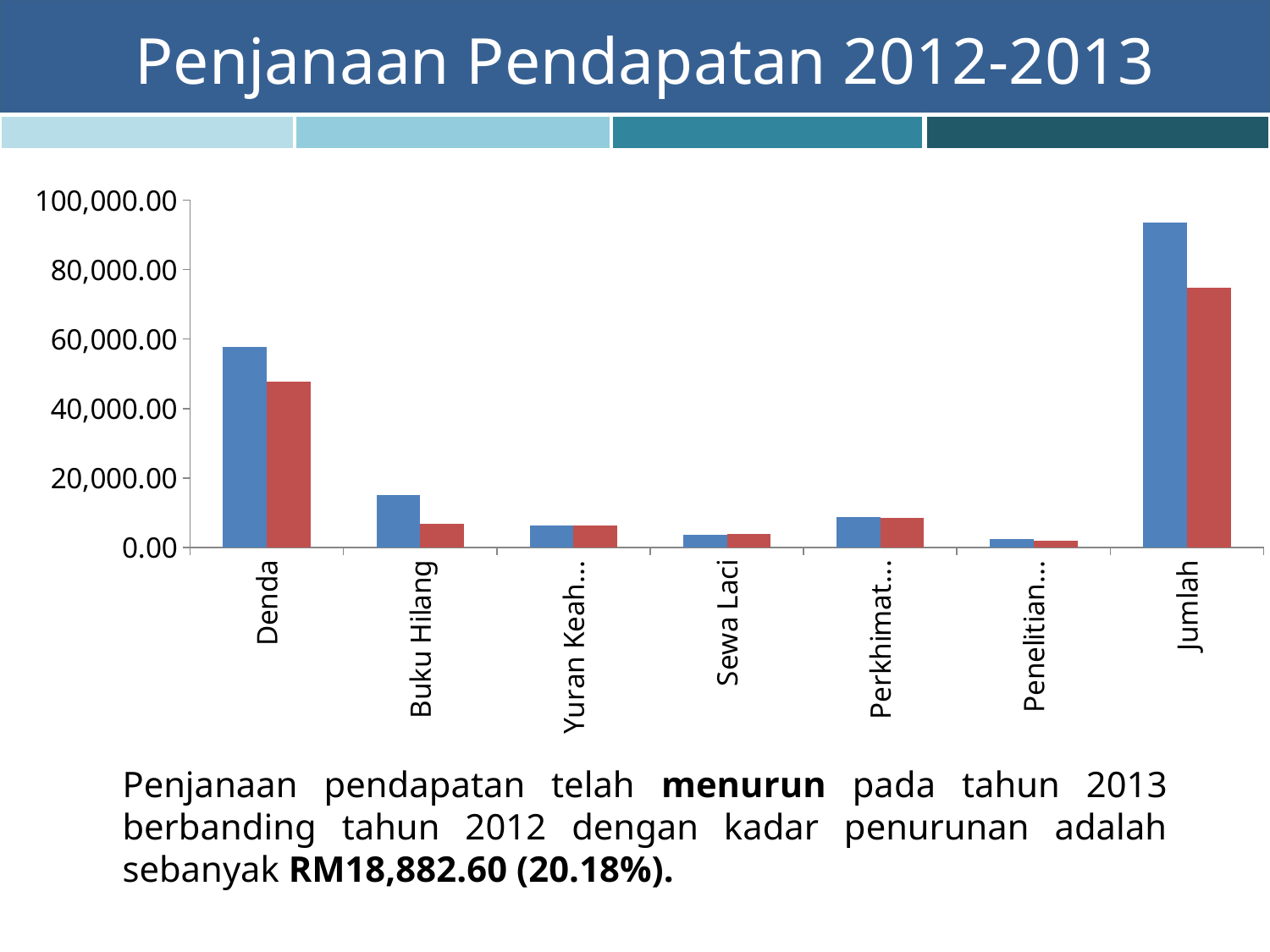
Is the blue bar for Jumlah greater or less than 80,000.00? greater What kind of chart is shown on the slide? bar chart For Buku Hilang, which bar is taller, the blue one or the red one? blue Which category has the tallest bars in the chart? Jumlah How many categories are shown on the x axis of the chart? 7 Excluding Jumlah, which category has the highest blue bar? Denda Is the blue bar for Buku Hilang greater or less than 20,000.00? less For Denda, which bar is taller, the blue one or the red one? blue Is the red bar for Jumlah greater or less than 80,000.00? less What is the title of the slide containing the chart? Penjanaan Pendapatan 2012-2013 How many series (bars per category) are plotted in the chart? 2